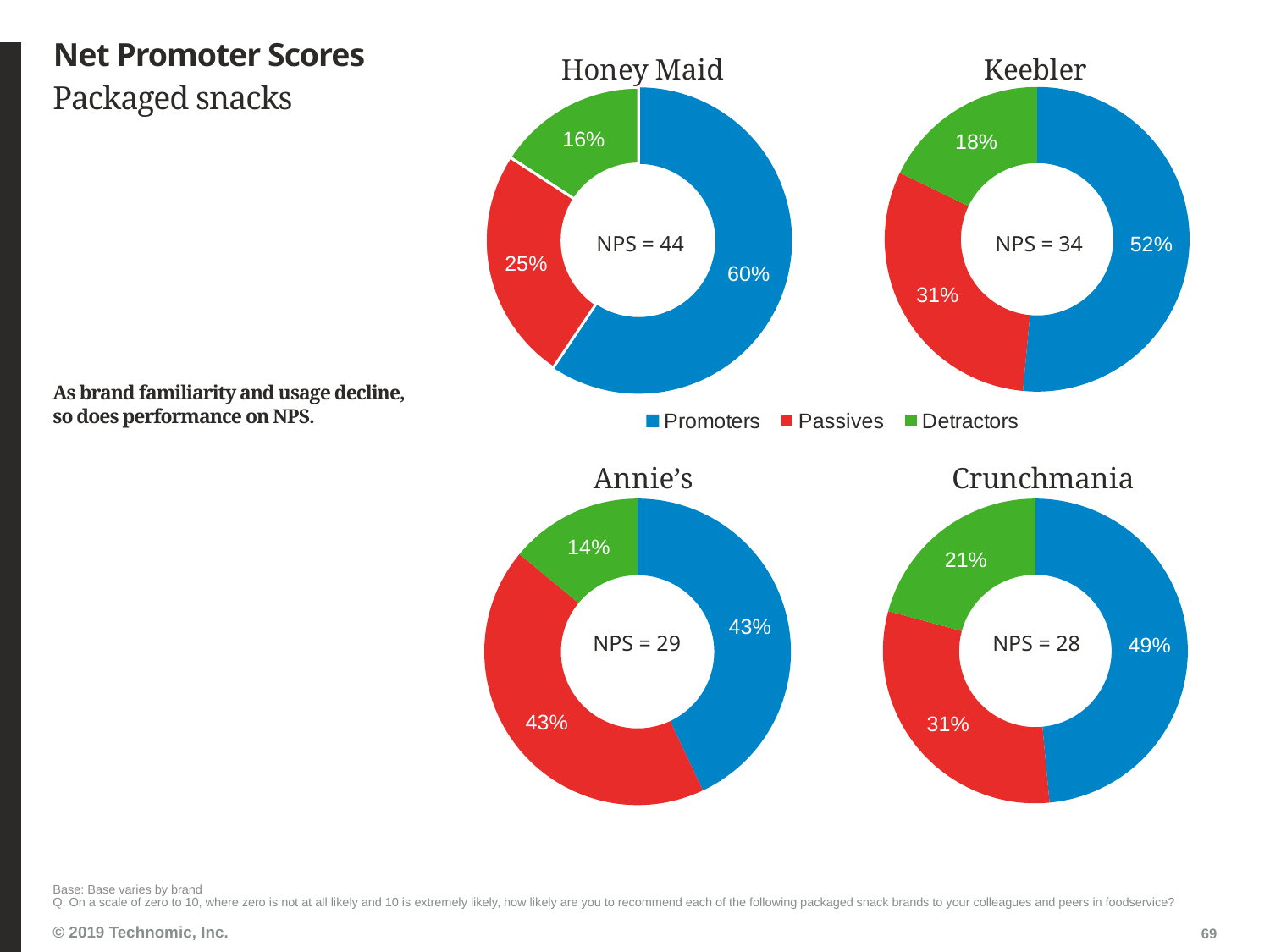
In the Annie's chart, which is larger, Promoters or Passives? They are equal (43%) In the Crunchmania chart, what is the NPS shown in the centre? NPS = 28 Which colour represents Passives in the legend? Red What kind of chart is used for Honey Maid? Donut (pie) chart How many series does the legend list? 3 In the Honey Maid chart, what percentage are Promoters? 60% In the Crunchmania chart, which segment is the smallest? Detractors How many segments does each donut chart have? 3 In the Annie's chart, what percentage are Detractors? 14% In the Keebler chart, what is the difference between the Promoters and Detractors percentages? 34% In the Keebler chart, what percentage are Passives? 31% In the Honey Maid chart, which segment is the largest? Promoters